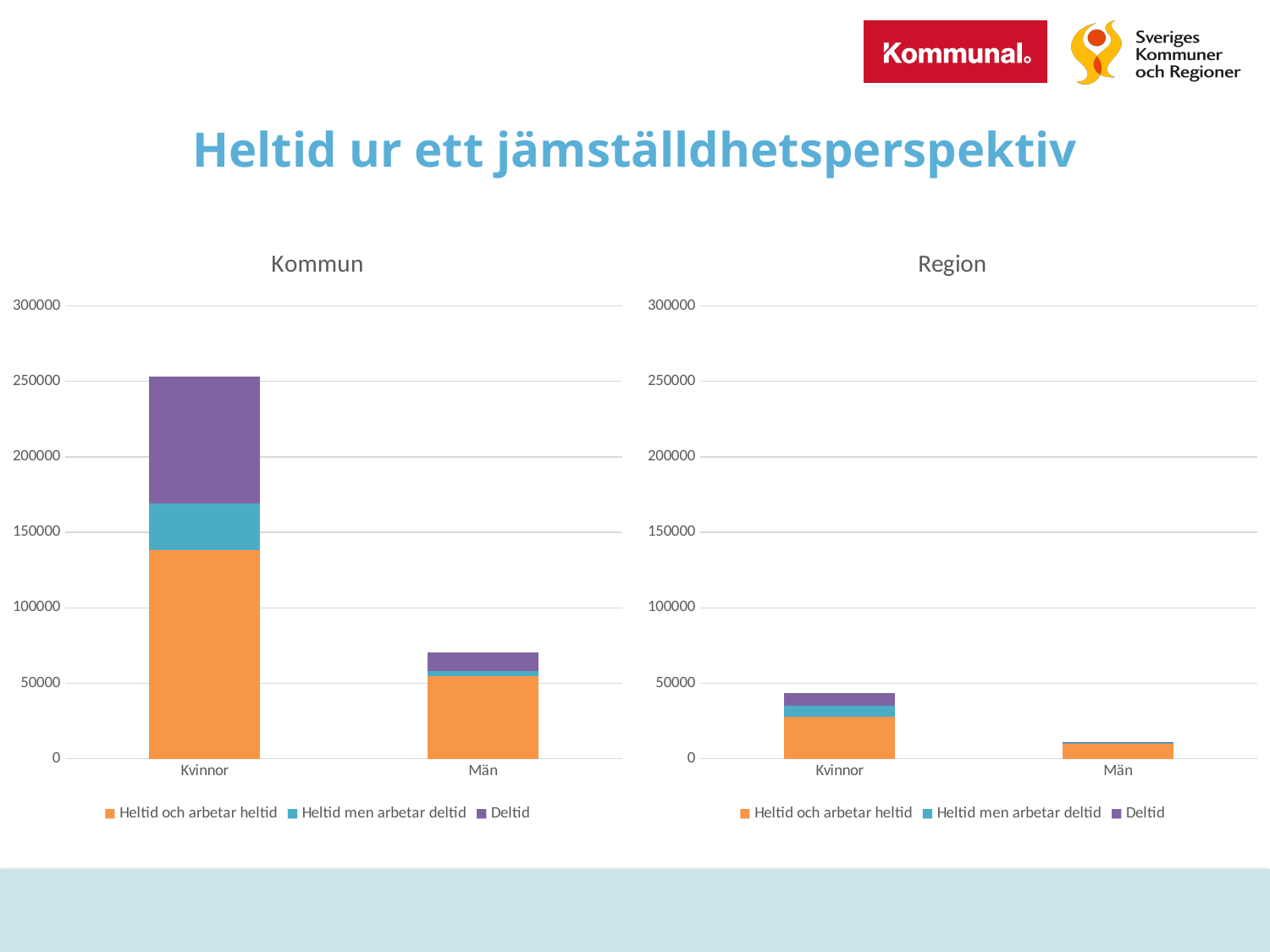
What is the title of the chart on the right side of the slide? Region In the Kommun chart, is the total bar for Kvinnor greater or less than 200000? greater In the Region chart, is the total bar for Män greater or less than 50000? less How many series does the legend of the Kommun chart list? 3 In the Kommun chart, is the total bar for Män greater or less than 50000? greater What type of chart is the Kommun chart? stacked bar chart Which colour represents the 'Deltid' series in the legend? purple In the Region chart, which category has the lowest total bar? Män How many categories are shown on the x axis of the Region chart? 2 In the Kommun chart, which category has the taller stacked bar, Kvinnor or Män? Kvinnor